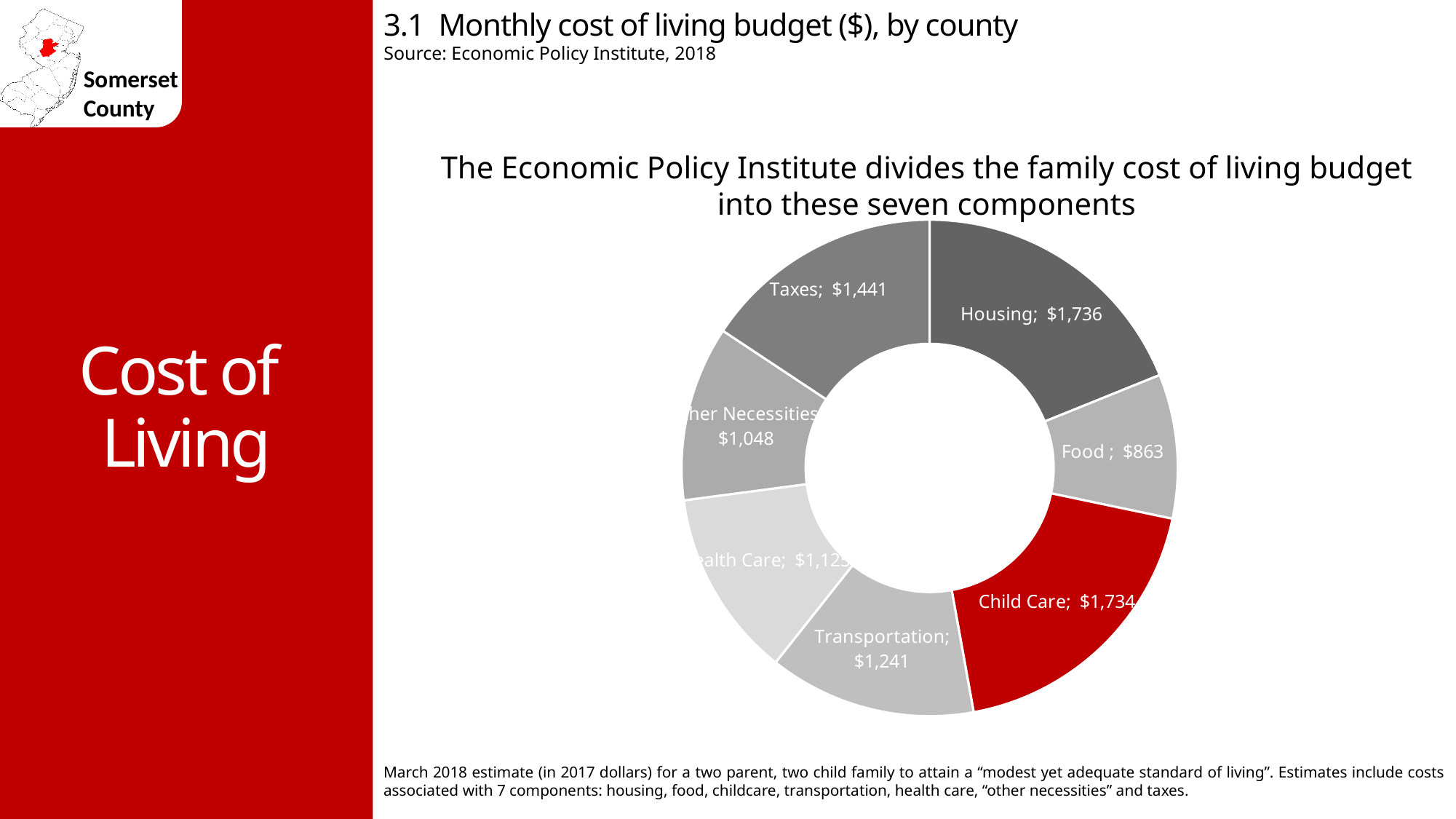
What is the monthly Food cost shown on the chart? $863 What is the difference between the Housing cost and the Food cost? $873 What is the monthly Child Care cost shown on the chart? $1,734 What is the monthly Transportation cost shown on the chart? $1,241 Which component's slice is coloured red? Child Care Which is larger, the Taxes cost or the Transportation cost? Taxes What is the monthly Housing cost shown on the chart? $1,736 What kind of chart is shown on the slide? Doughnut chart Which component has the lowest monthly cost? Food What is the monthly Taxes cost shown on the chart? $1,441 How many components are shown in the chart? 7 What is the difference between the Taxes cost and the Transportation cost? $200